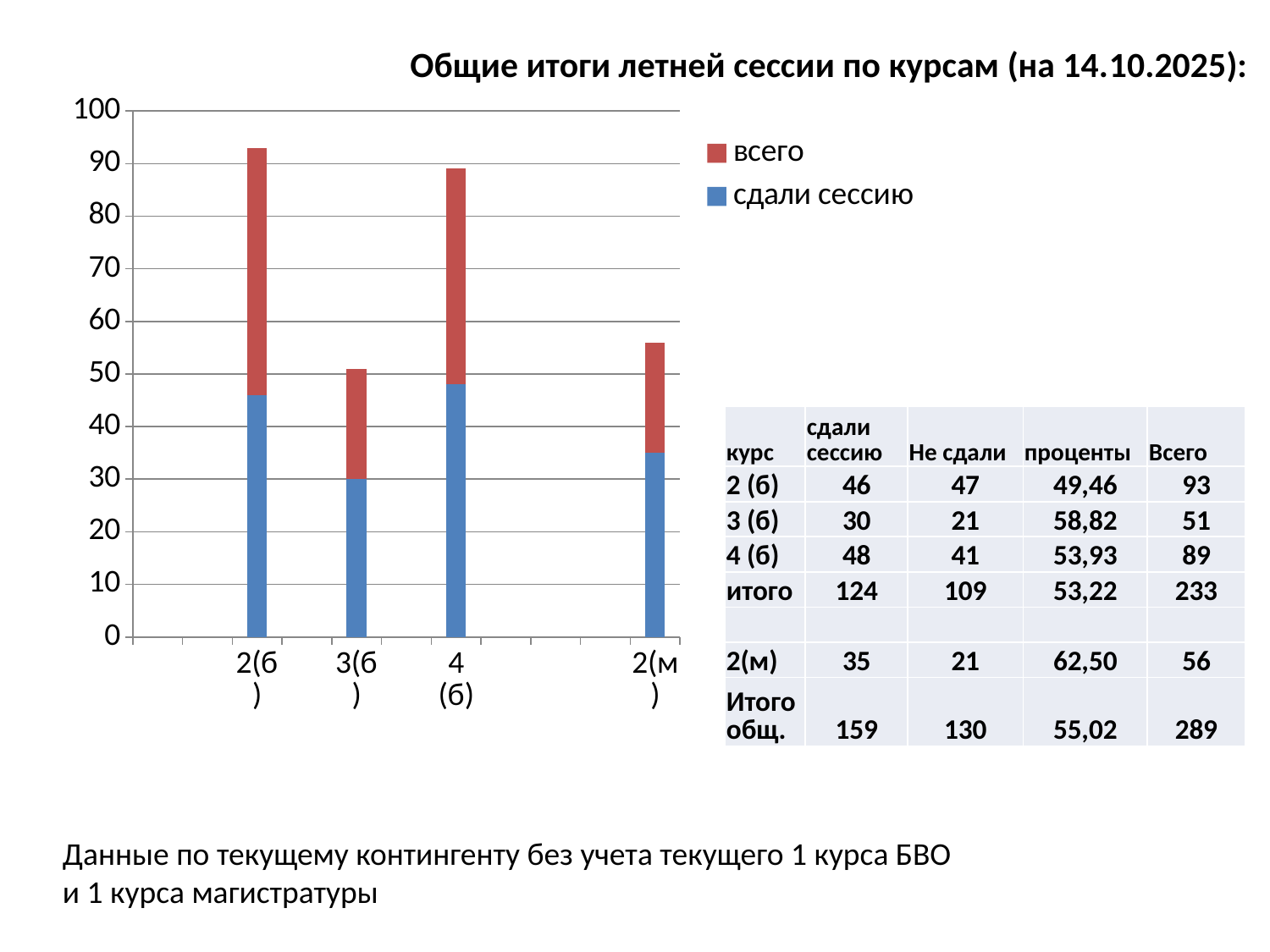
Which course has the lowest "всего" value? 3(б) What is the difference between "всего" and "сдали сессию" for course 3(б)? 21 Which course has the highest "всего" value? 2(б) Is the value of "сдали сессию" for course 2(м) greater or less than 40? less What is the value of "сдали сессию" for course 3(б)? 30 How many series does the chart legend list? 2 Which course has the larger "всего" value, 3(б) or 2(м)? 2(м) Is the value of "всего" for course 4(б) greater or less than 80? greater What are the two entries in the chart legend? всего, сдали сессию What is the value of "всего" for course 2(б)? 93 How many course categories are plotted on the x axis of the chart? 4 What kind of chart is shown on the slide? bar chart